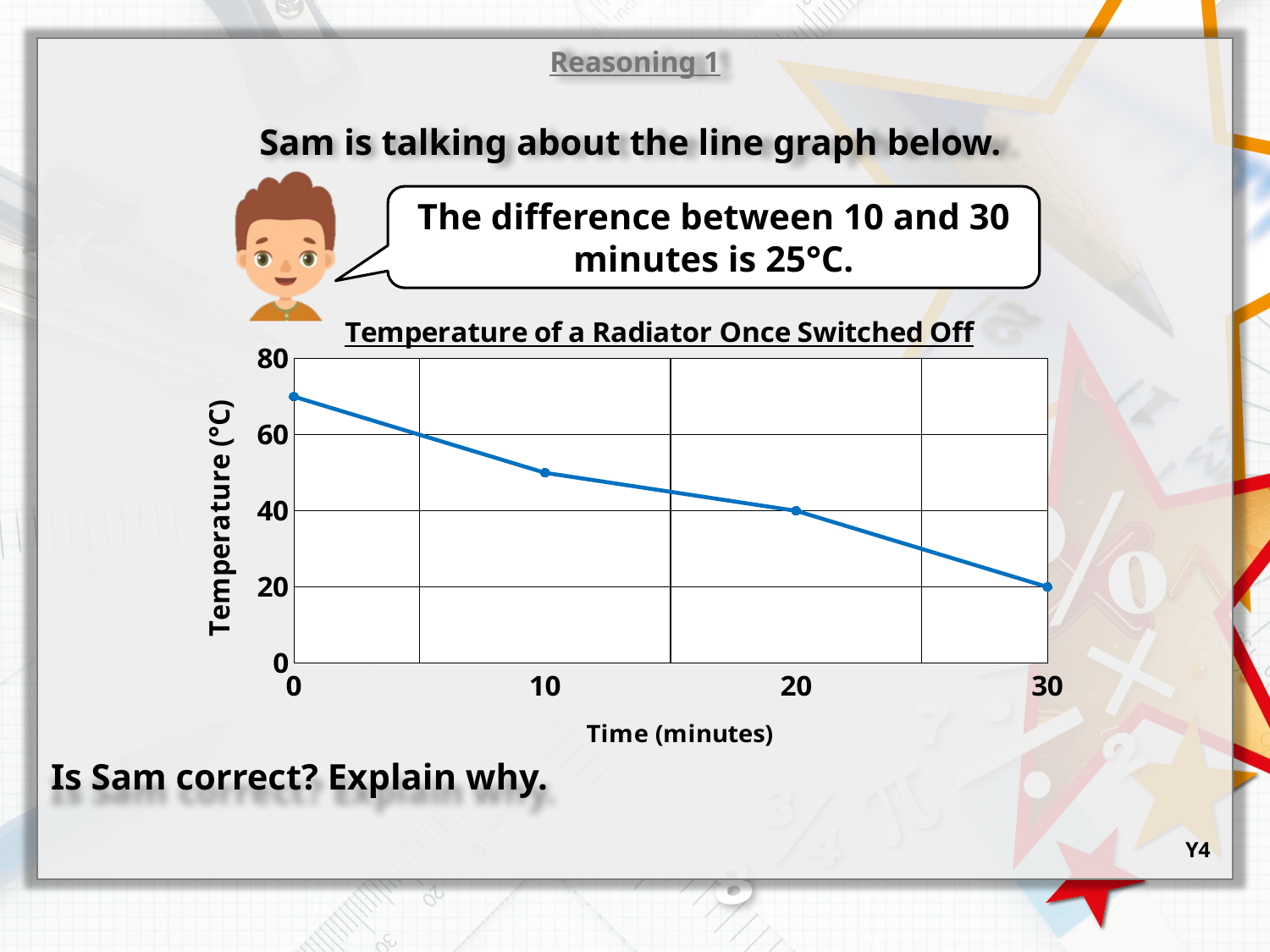
Which has the higher temperature, 10 minutes or 20 minutes? 10 minutes What type of chart is shown on the slide? Line chart Does the temperature rise or fall as time increases? Fall Is the temperature at 10 minutes greater or less than 60? less At which time is the temperature lowest? 30 minutes What is the title of the chart? Temperature of a Radiator Once Switched Off Is the temperature at 0 minutes greater or less than 60? greater What is the temperature at 20 minutes? 40 How many data points are plotted on the line? 4 What is the temperature at 30 minutes? 20 At which time is the temperature highest? 0 minutes What is the difference in temperature between 20 minutes and 30 minutes? 20